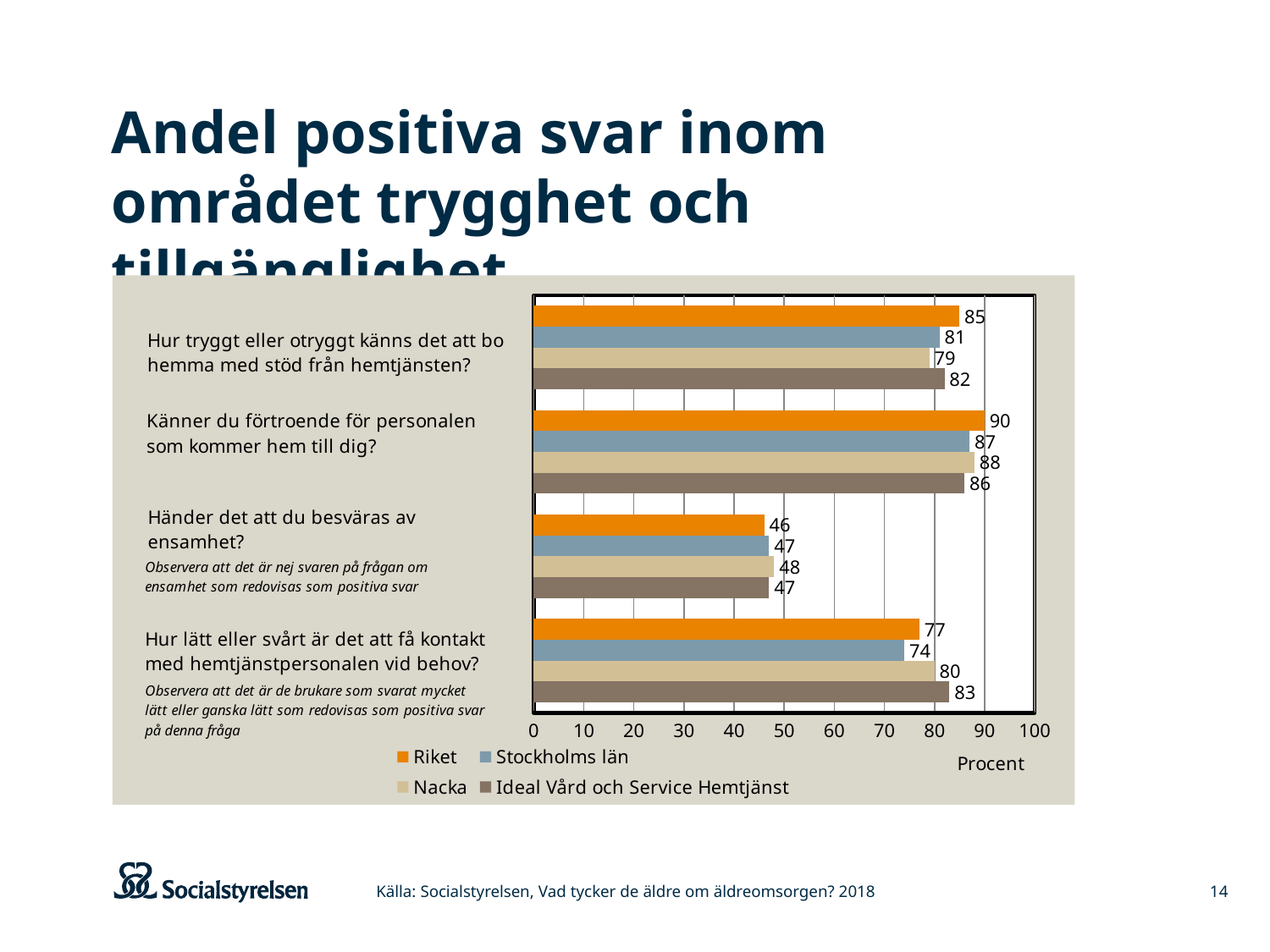
Is the Riket value for "Händer det att du besväras av ensamhet?" greater or less than 50? less What is the value for Stockholms län on the question "Händer det att du besväras av ensamhet?"? 47 What is the value for Ideal Vård och Service Hemtjänst on the question "Hur lätt eller svårt är det att få kontakt med hemtjänstpersonalen vid behov?"? 83 Which series has the highest value on the question "Hur lätt eller svårt är det att få kontakt med hemtjänstpersonalen vid behov?"? Ideal Vård och Service Hemtjänst Which is larger on the question "Hur lätt eller svårt är det att få kontakt med hemtjänstpersonalen vid behov?": the value for Riket or the value for Nacka? Nacka How many series does the legend list? 4 What is the label on the horizontal axis of the chart? Procent What is the value for Riket on the question "Känner du förtroende för personalen som kommer hem till dig?"? 90 Which series has the lowest value on the question "Hur tryggt eller otryggt känns det att bo hemma med stöd från hemtjänsten?"? Nacka What is the difference between the Riket value and the Stockholms län value on the question "Hur tryggt eller otryggt känns det att bo hemma med stöd från hemtjänsten?"? 4 What is the value for Nacka on the question "Hur tryggt eller otryggt känns det att bo hemma med stöd från hemtjänsten?"? 79 What kind of chart is shown on the slide? bar chart